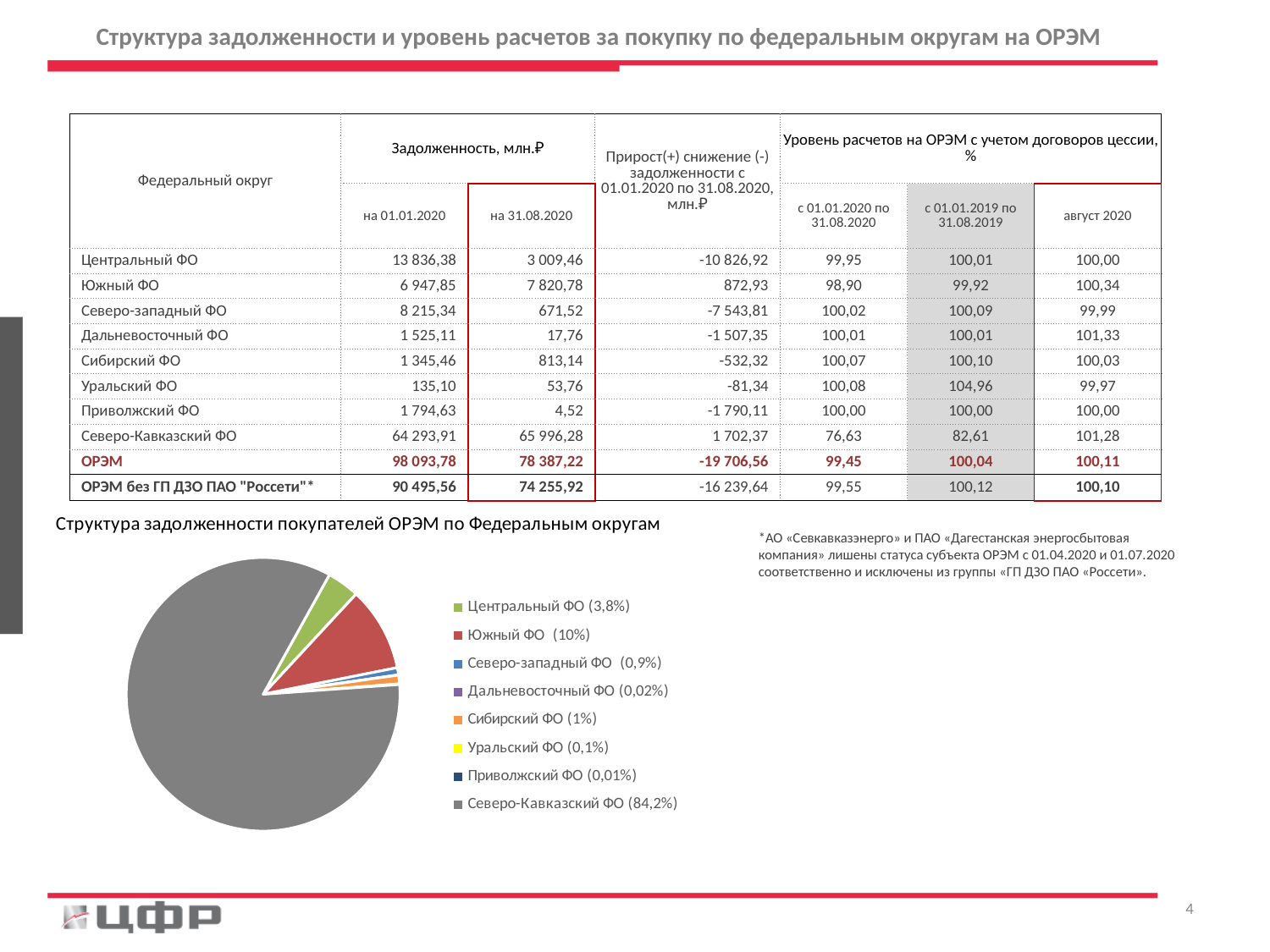
What share of the pie does Южный ФО have? 10% What kind of chart is shown on the slide? Pie chart What share of the pie does Сибирский ФО have? 1% Which federal district has the largest slice of the pie? Северо-Кавказский ФО What is the difference in share between Северо-Кавказский ФО and Южный ФО? 74,2% How many federal districts (slices) does the pie chart legend list? 8 Which has a larger share of the pie, Южный ФО or Центральный ФО? Южный ФО What is the title of the pie chart? Структура задолженности покупателей ОРЭМ по Федеральным округам What share of the pie does Северо-Кавказский ФО have? 84,2% What colour is the largest slice of the pie chart? Grey Which federal district has the smallest share in the pie chart? Приволжский ФО